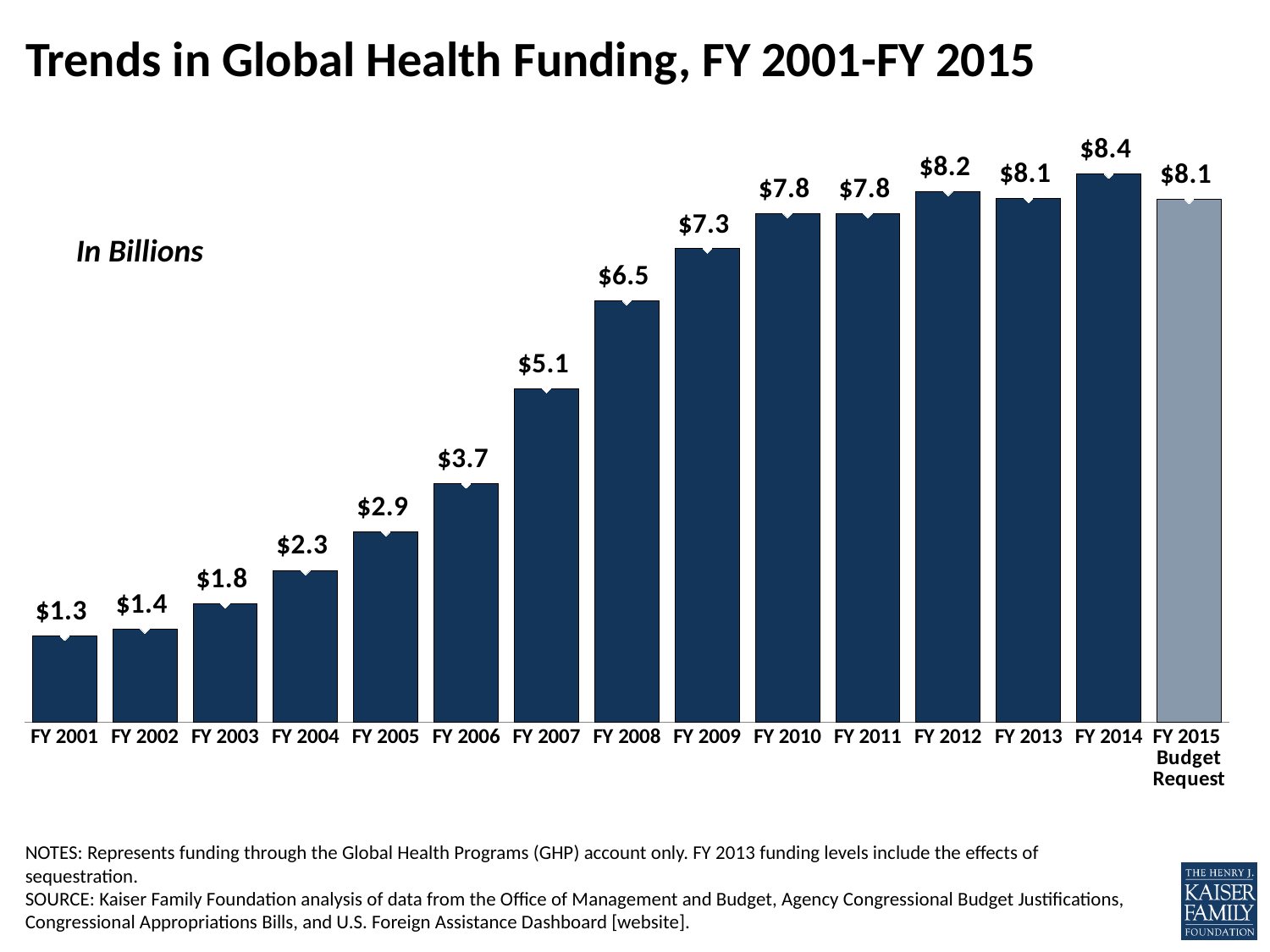
What kind of chart is shown on the slide? Bar chart What is the difference between the FY 2014 value and the FY 2001 value? $7.1 Which fiscal year has the lowest funding value? FY 2001 Which fiscal year has the highest funding value? FY 2014 What is the title of the chart? Trends in Global Health Funding, FY 2001-FY 2015 Which is larger, the value for FY 2012 or the value for FY 2013? FY 2012 What is the global health funding value for FY 2007? $5.1 What is the difference between the FY 2008 and FY 2007 values? $1.4 What is the value shown for the FY 2015 Budget Request? $8.1 What is the funding value for FY 2001? $1.3 Do the values generally rise or fall from FY 2001 to FY 2014? Rise How many bars are shown in the chart? 15